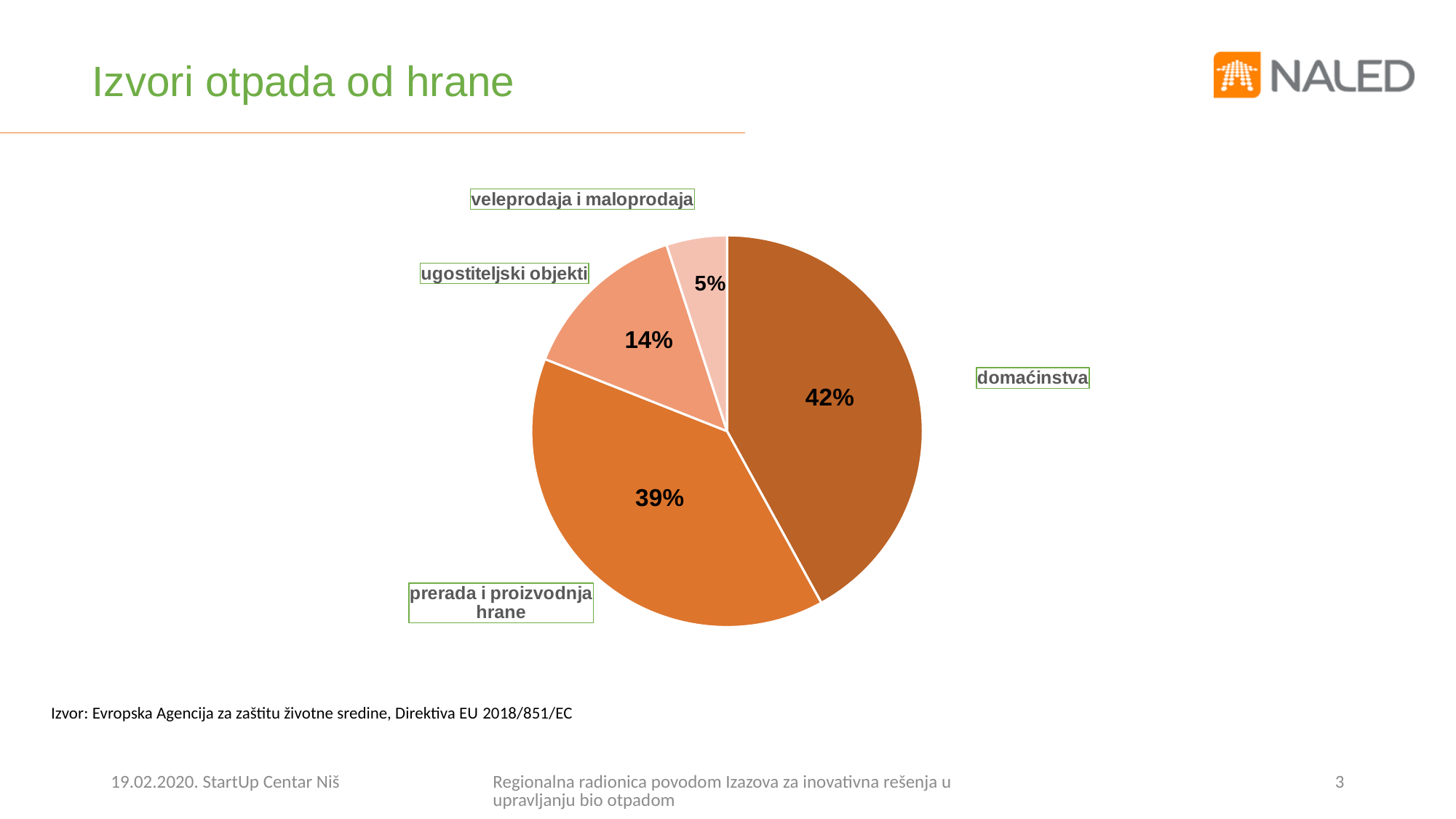
What kind of chart is shown on the slide? pie chart Which is larger, the share for ugostiteljski objekti or the share for veleprodaja i maloprodaja? ugostiteljski objekti Which category has the largest share of the pie? domaćinstva What share of food waste comes from veleprodaja i maloprodaja? 5% What is the difference in percentage points between domaćinstva and prerada i proizvodnja hrane? 3 What share of food waste comes from domaćinstva? 42% How many categories are shown in the pie chart? 4 What share of food waste comes from ugostiteljski objekti? 14% What is the title of the slide containing the chart? Izvori otpada od hrane Which category has the smallest share of the pie? veleprodaja i maloprodaja What share of food waste comes from prerada i proizvodnja hrane? 39% What is the difference in percentage points between ugostiteljski objekti and veleprodaja i maloprodaja? 9